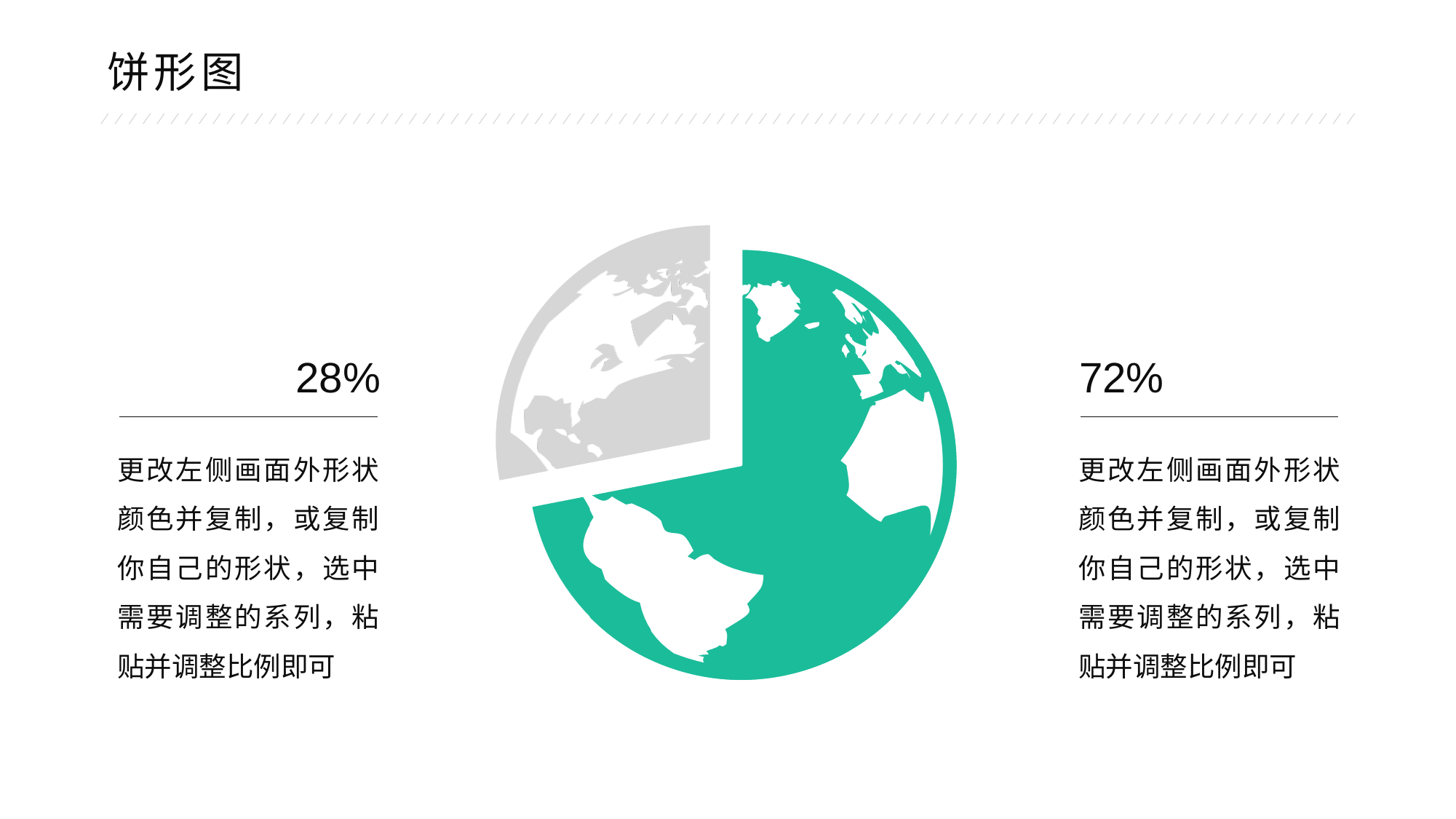
Is the share of the gray slice greater or less than 50%? less Which slice of the pie chart is the smallest? the gray slice (28%) What do the two percentages shown on the slide add up to? 100% What two colours are used for the slices of the pie chart? gray and green How many slices does the pie chart have? 2 What share of the pie does the green slice represent? 72% What share of the pie does the gray slice represent? 28% Which is larger, the green slice or the gray slice? the green slice Which slice of the pie chart is the largest? the green slice (72%) What is the difference in percentage points between the green slice and the gray slice? 44 percentage points What kind of chart is shown on the slide? pie chart What is the title of the slide? 饼形图